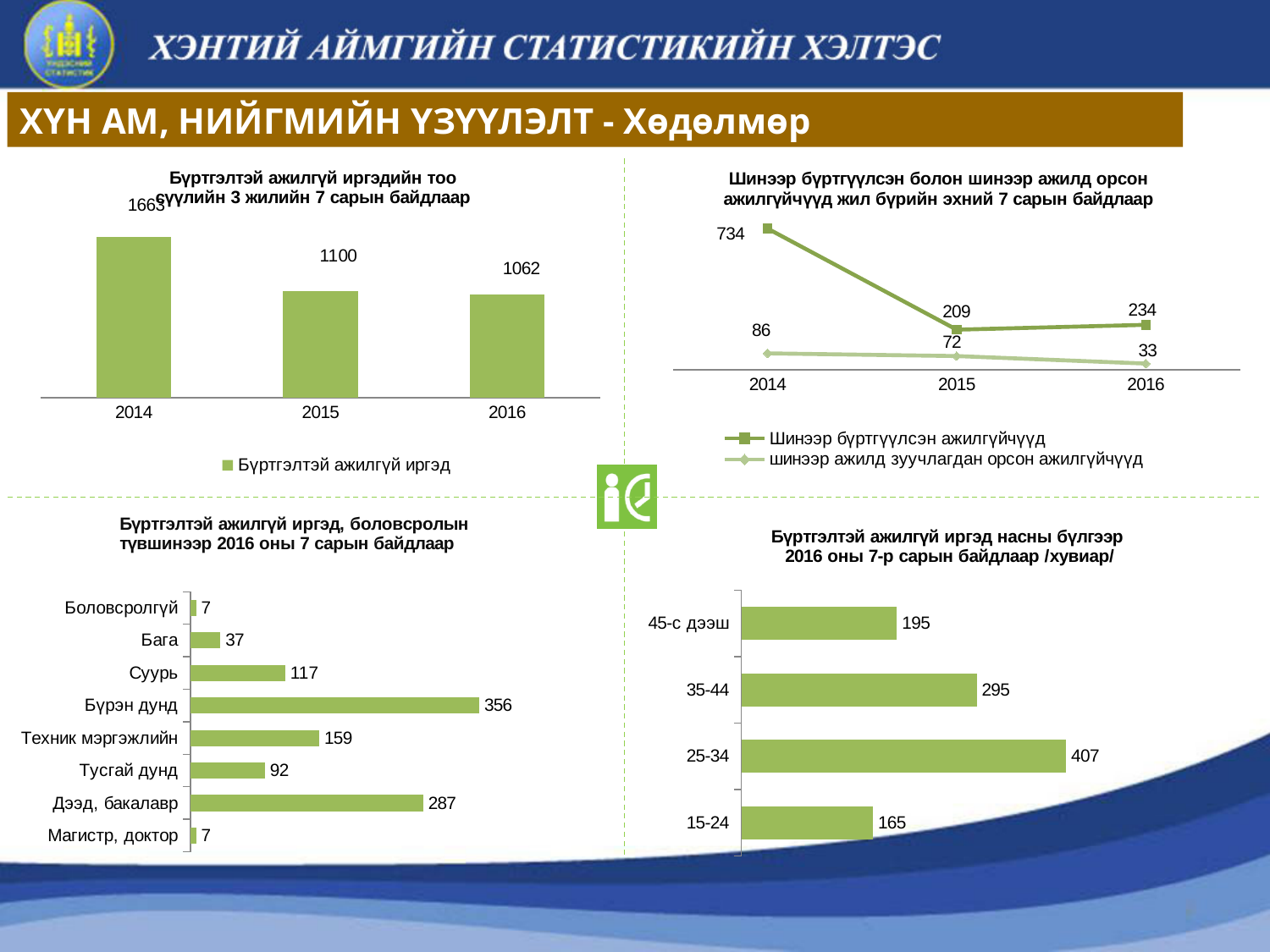
In the bottom-right chart, which age group has the lowest value? 15-24 How many categories are shown in the bottom-left chart? 8 In the top-right chart, what is the value for шинээр ажилд зуучлагдан орсон ажилгүйчүүд in 2016? 33 What kind of chart is the top-right chart? line chart In the top-left chart, what is the difference between the values for 2014 and 2016? 601 In the bottom-left chart, which category has the highest value? Бүрэн дунд How many series does the legend of the top-right chart list? 2 In the bottom-right chart, which is larger, the value for 35-44 or the value for 45-с дээш? 35-44 In the top-right chart, what is the value for Шинээр бүртгүүлсэн ажилгүйчүүд in 2015? 209 In the bottom-left chart, what is the value for Техник мэргэжлийн? 159 In the top-left chart, what is the value for 2014? 1663 In the top-left chart, do the values rise or fall from 2014 to 2016? fall